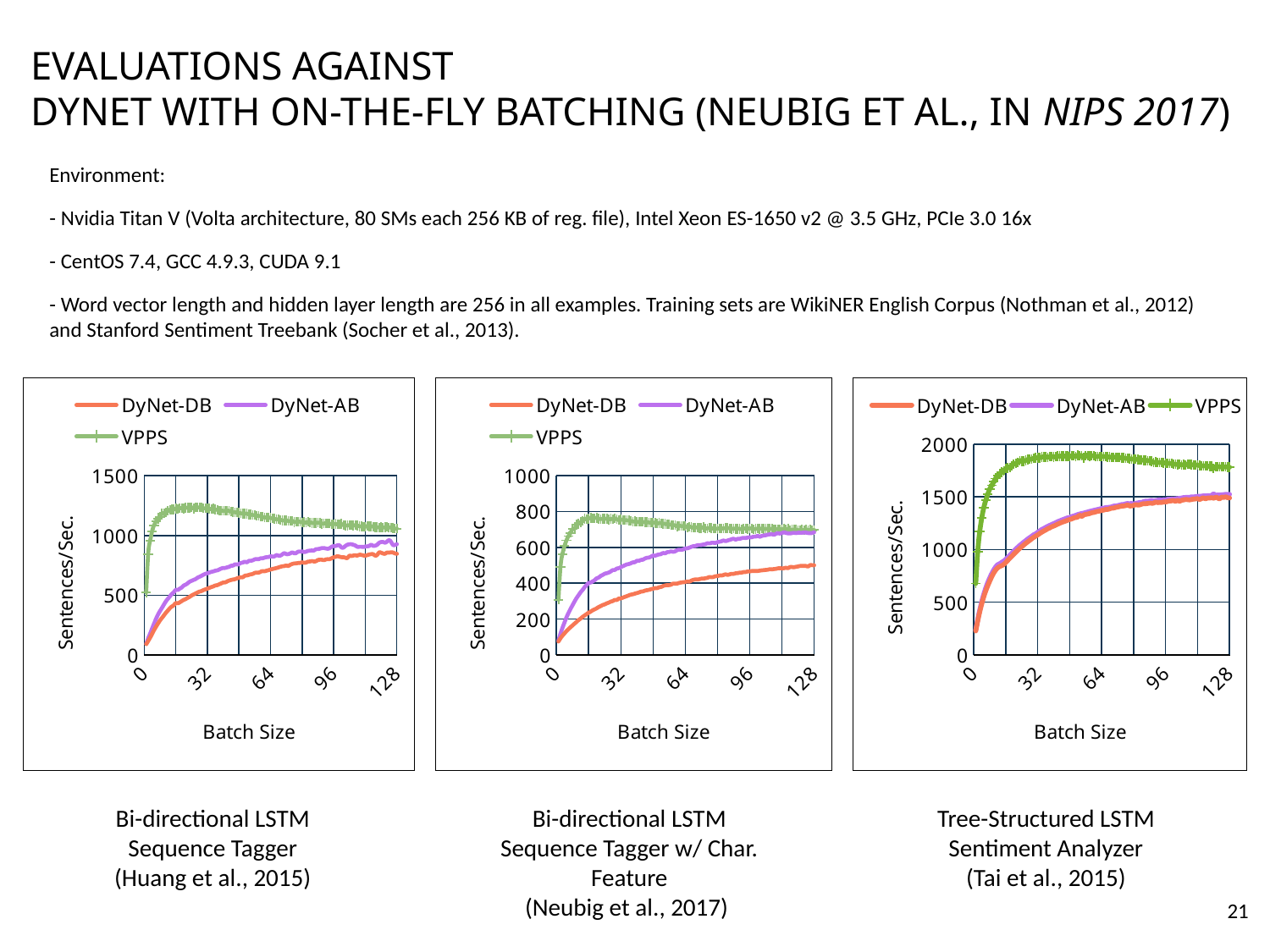
In the middle chart (Bi-directional LSTM Sequence Tagger w/ Char. Feature), is the DyNet-DB value at batch size 128 greater or less than 600? less In the left chart (Bi-directional LSTM Sequence Tagger), which series has the larger value at batch size 128, VPPS or DyNet-DB? VPPS In the right chart (Tree-Structured LSTM Sentiment Analyzer), is the VPPS value at batch size 128 greater or less than 1500? greater In the left chart (Bi-directional LSTM Sequence Tagger), is the VPPS value at batch size 32 greater or less than 1000? greater In the right chart (Tree-Structured LSTM Sentiment Analyzer), does the DyNet-DB series generally rise or fall as batch size increases? rise How many series does the legend of the right chart (Tree-Structured LSTM Sentiment Analyzer) list? 3 In the left chart (Bi-directional LSTM Sequence Tagger), what is the label of the x axis? Batch Size In the middle chart (Bi-directional LSTM Sequence Tagger w/ Char. Feature), which series has the larger value at batch size 128, VPPS or DyNet-DB? VPPS What kind of chart is the left chart (Bi-directional LSTM Sequence Tagger)? line chart In the middle chart (Bi-directional LSTM Sequence Tagger w/ Char. Feature), what is the label of the y axis? Sentences/Sec.